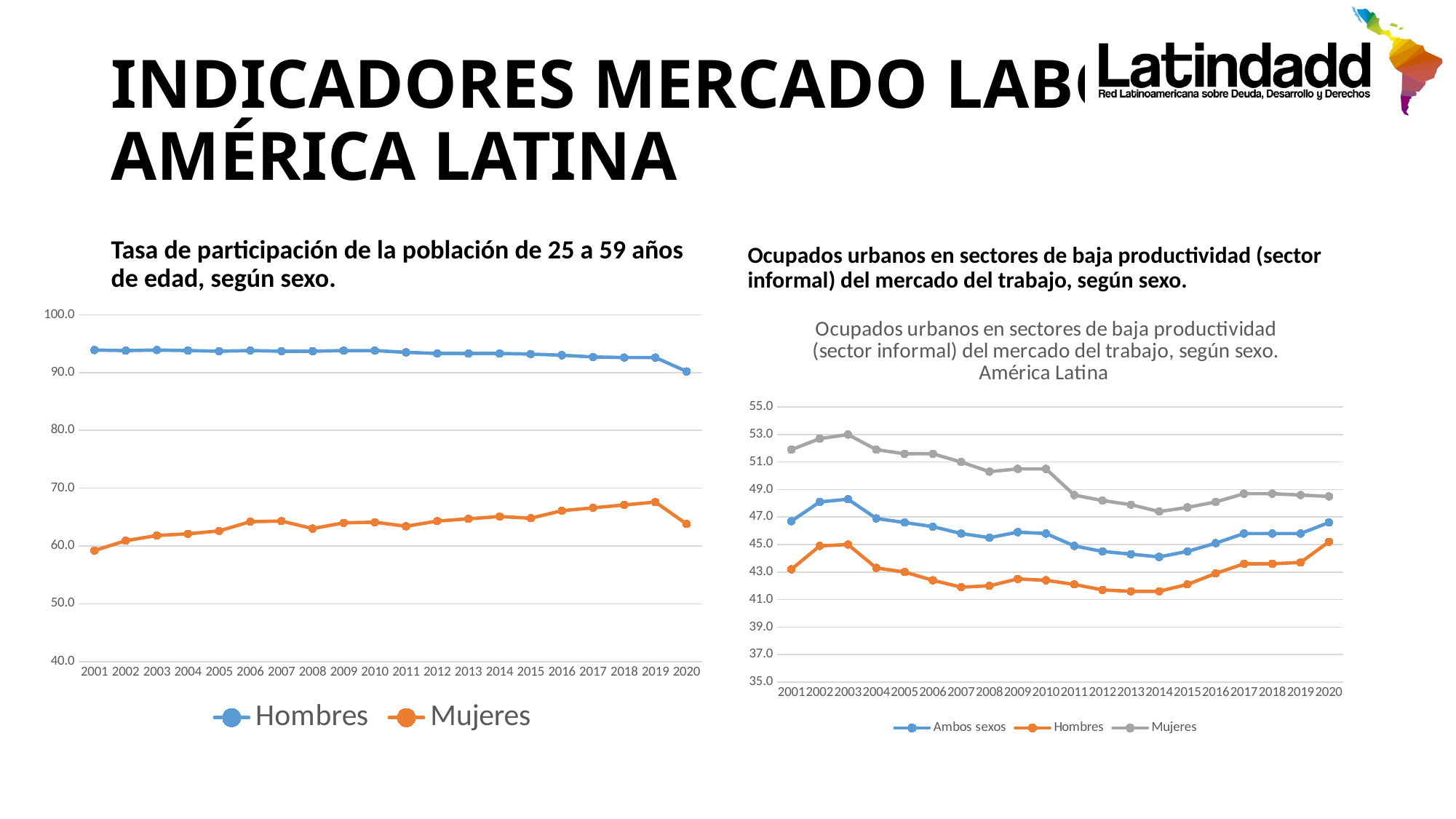
In the right chart (Ocupados urbanos en sectores de baja productividad), which series has the larger value in 2020, Hombres or Mujeres? Mujeres In the left chart (Tasa de participación), does the Hombres series rise or fall from 2001 to 2020? Fall In the left chart (Tasa de participación), in which year does the Mujeres series reach its highest value? 2019 How many series does the legend of the left chart (Tasa de participación) list? 2 What kind of chart is the left chart, 'Tasa de participación de la población de 25 a 59 años de edad, según sexo'? Line chart In the left chart (Tasa de participación), is the value for Mujeres in 2001 greater or less than 60? less How many years are plotted along the x axis of the left chart (Tasa de participación)? 20 How many series does the legend of the right chart (Ocupados urbanos en sectores de baja productividad) list? 3 In the left chart (Tasa de participación), is the value for Hombres in 2001 greater or less than 90? greater In the right chart (Ocupados urbanos en sectores de baja productividad), is the value for Hombres in 2007 greater or less than 43? less In the right chart (Ocupados urbanos en sectores de baja productividad), in which year does the Mujeres series reach its highest value? 2003 In the left chart (Tasa de participación), which series has the larger value in 2010, Hombres or Mujeres? Hombres